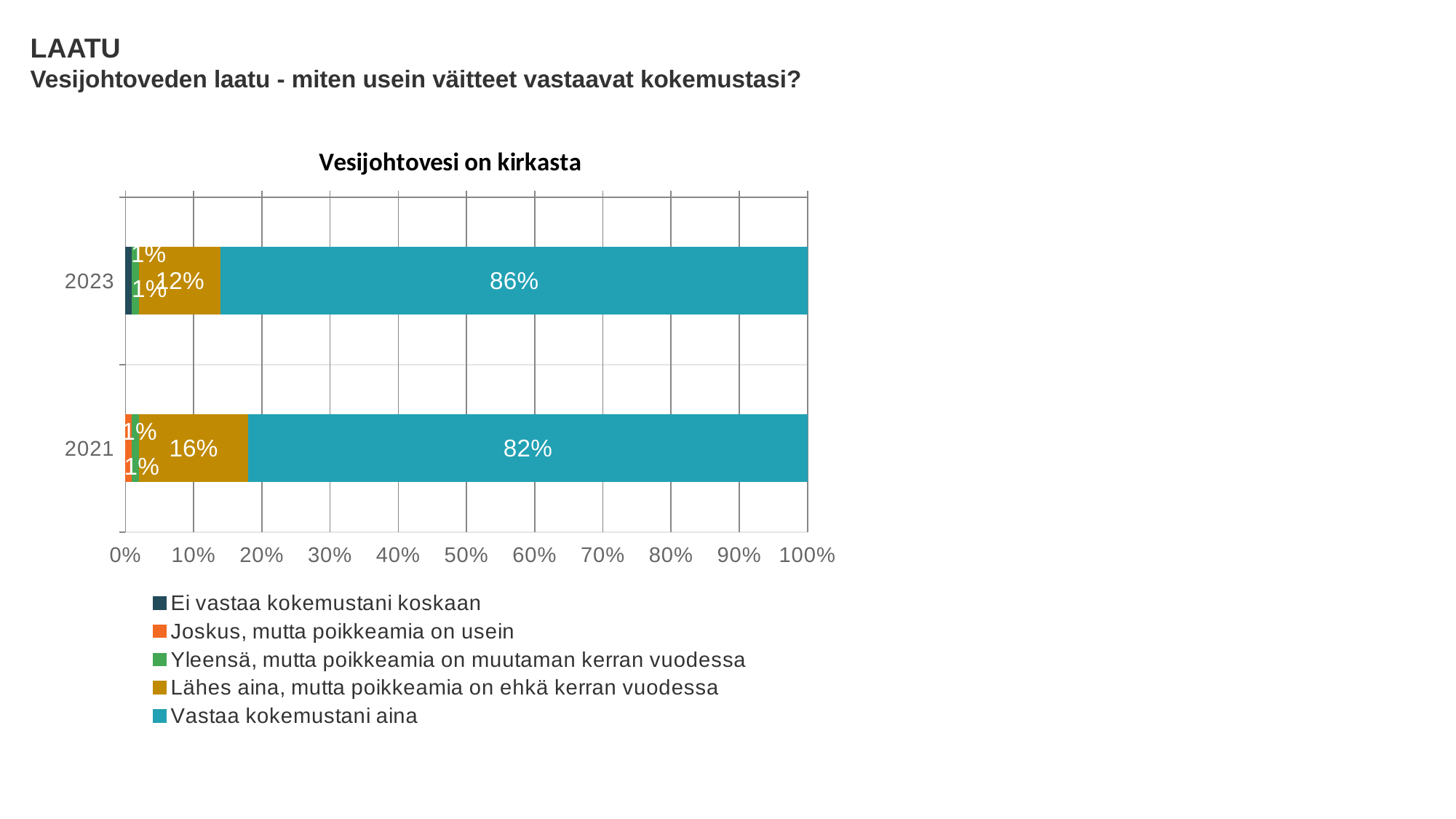
By how many percentage points does the "Vastaa kokemustani aina" share in 2023 exceed that in 2021? 4 percentage points How many years (categories) are shown on the chart? 2 Which year has the larger share for "Vastaa kokemustani aina", 2021 or 2023? 2023 What is the value for "Vastaa kokemustani aina" in 2023? 86% Is the value for "Lähes aina, mutta poikkeamia on ehkä kerran vuodessa" in 2021 greater or less than 20%? less What is the difference between the "Lähes aina, mutta poikkeamia on ehkä kerran vuodessa" values for 2021 and 2023? 4 percentage points Which year has the larger share for "Lähes aina, mutta poikkeamia on ehkä kerran vuodessa", 2021 or 2023? 2021 What is the value for "Vastaa kokemustani aina" in 2021? 82% What kind of chart is shown on the slide? Stacked bar chart What is the value for "Lähes aina, mutta poikkeamia on ehkä kerran vuodessa" in 2021? 16% How many series does the legend list? 5 What is the value for "Lähes aina, mutta poikkeamia on ehkä kerran vuodessa" in 2023? 12%